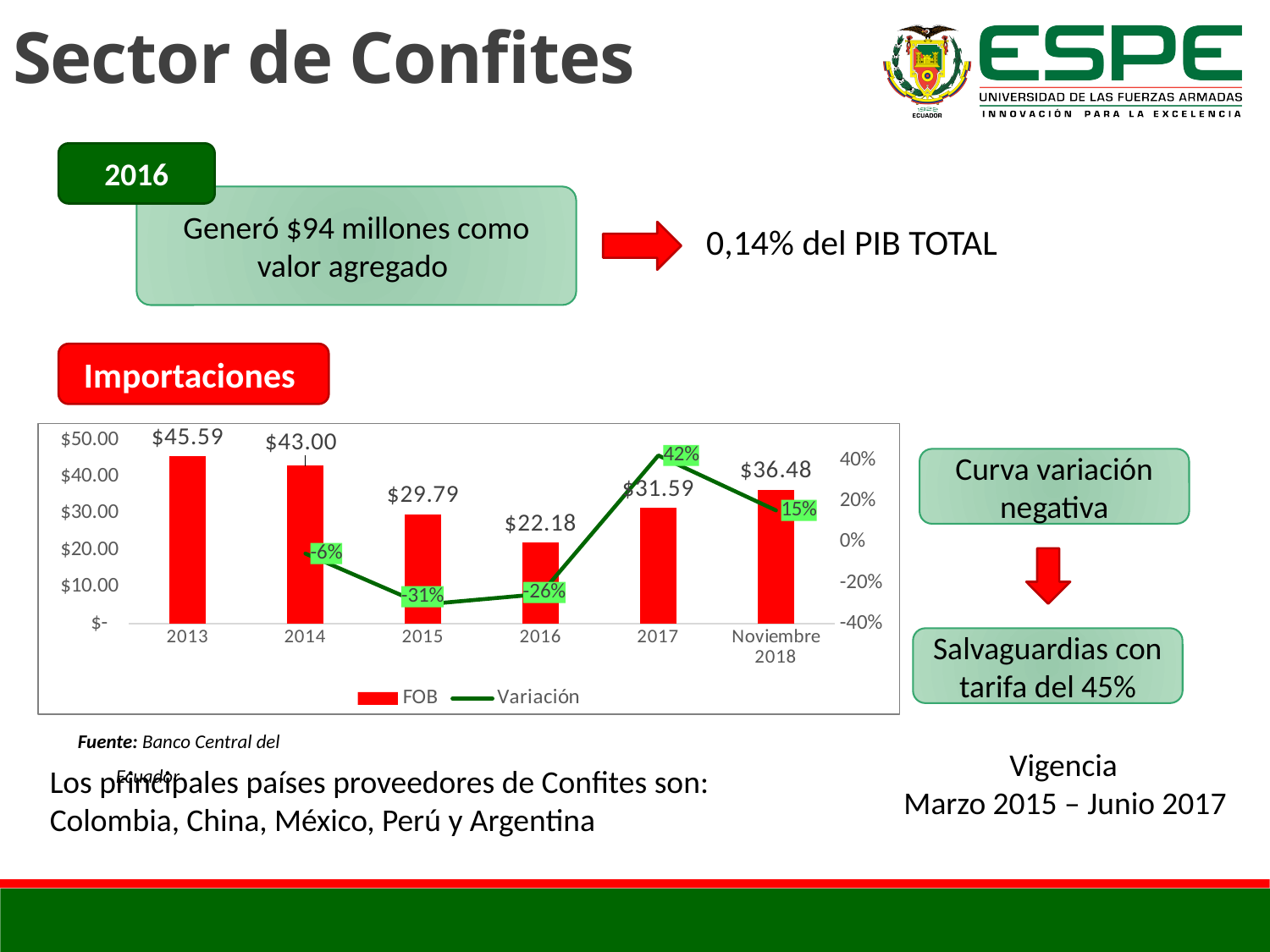
What is the FOB value for 2013? $45.59 What is the Variación value for 2015? -31% What is the difference between the FOB values for 2013 and 2014? $2.59 Which year has the lowest FOB value? 2016 What is the Variación value for 2017? 42% Which year has the highest FOB value? 2013 Do the FOB values rise or fall from 2013 to 2016? fall What kind of chart is used to show the FOB series? bar chart How many categories are shown on the x axis? 6 Which is larger, the FOB value for 2017 or for Noviembre 2018? Noviembre 2018 What is the FOB value for 2016? $22.18 How many series does the legend list? 2